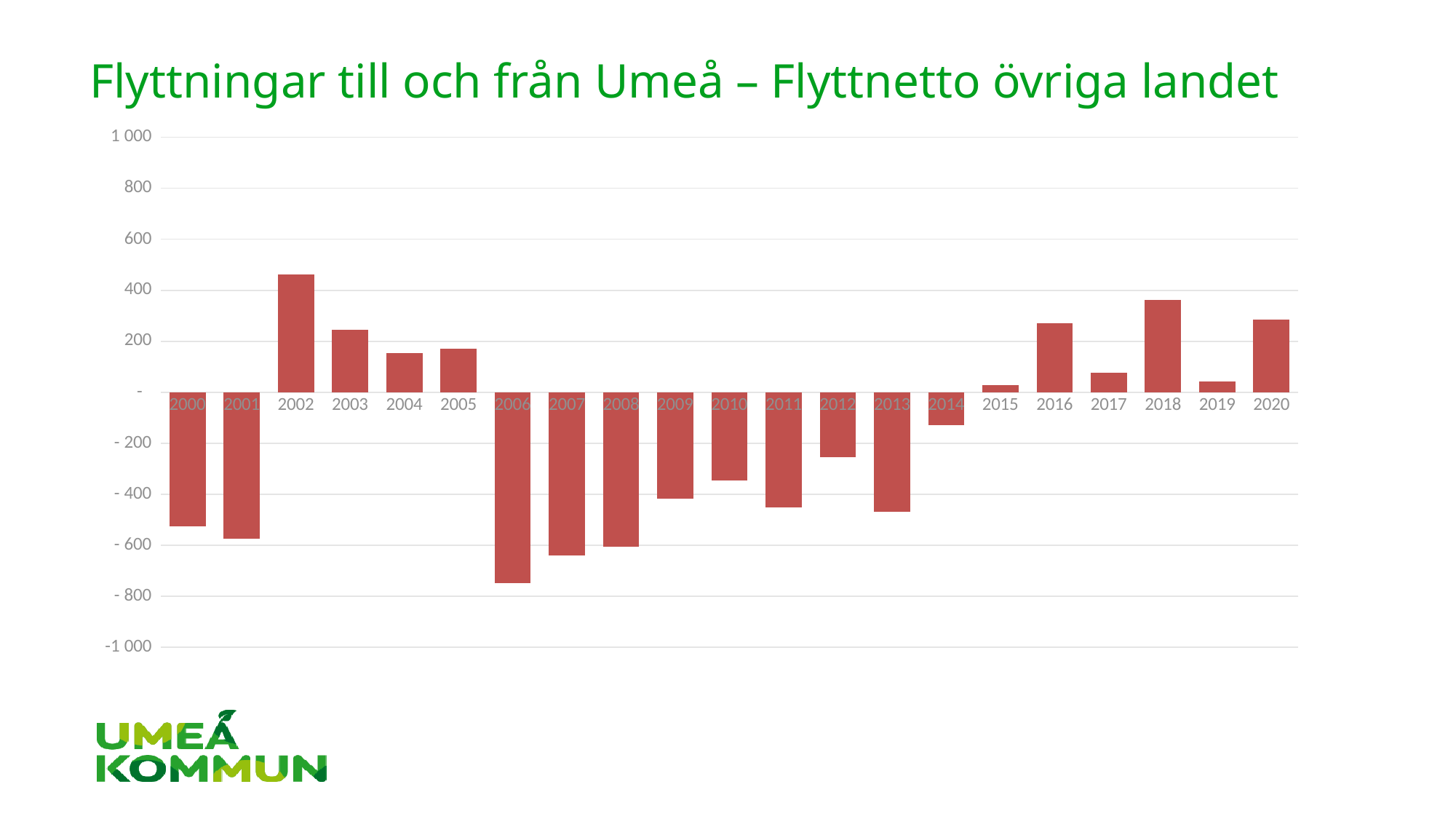
Is the value for 2018 greater or less than 200? greater Which year has the highest value in the chart? 2002 Is the value for 2002 greater or less than 400? greater How many years are shown on the x axis of the chart? 21 Which year has the lowest value in the chart? 2006 Which year has the larger value, 2002 or 2018? 2002 What kind of chart is shown on the slide? bar chart Is the value for 2006 greater or less than -600? less What is the title of the chart? Flyttningar till och från Umeå – Flyttnetto övriga landet Do the values generally rise or fall from 2006 to 2014? rise